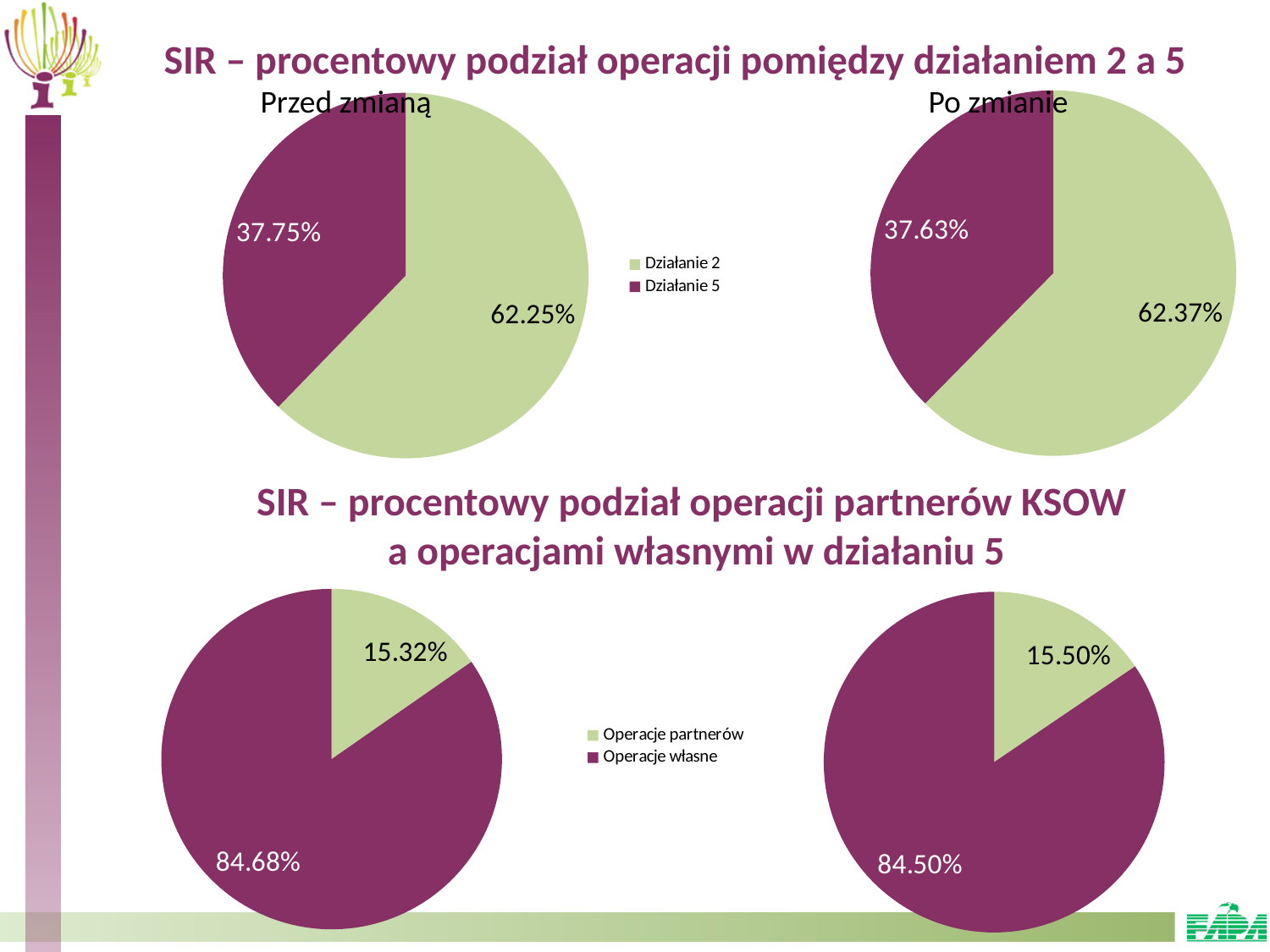
In the bottom-left pie chart, what is the value for Operacje własne? 84.68% In the top-right pie chart (Po zmianie), what is the value for Działanie 2? 62.37% What type of chart is used for the top-right chart (Po zmianie)? Pie chart In the top-right pie chart (Po zmianie), what is the value for Działanie 5? 37.63% In the top-left pie chart (Przed zmianą), which category has the largest share? Działanie 2 In the bottom-right pie chart, what is the value for Operacje własne? 84.50% In the bottom-left pie chart, what is the value for Operacje partnerów? 15.32% In the bottom-left pie chart, which category has the smallest share? Operacje partnerów In the top-left pie chart (Przed zmianą), what is the value for Działanie 5? 37.75% In the top-left pie chart (Przed zmianą), what is the value for Działanie 2? 62.25% How many entries does the legend of the bottom charts list? 2 In the bottom-right pie chart, what is the value for Operacje partnerów? 15.50%